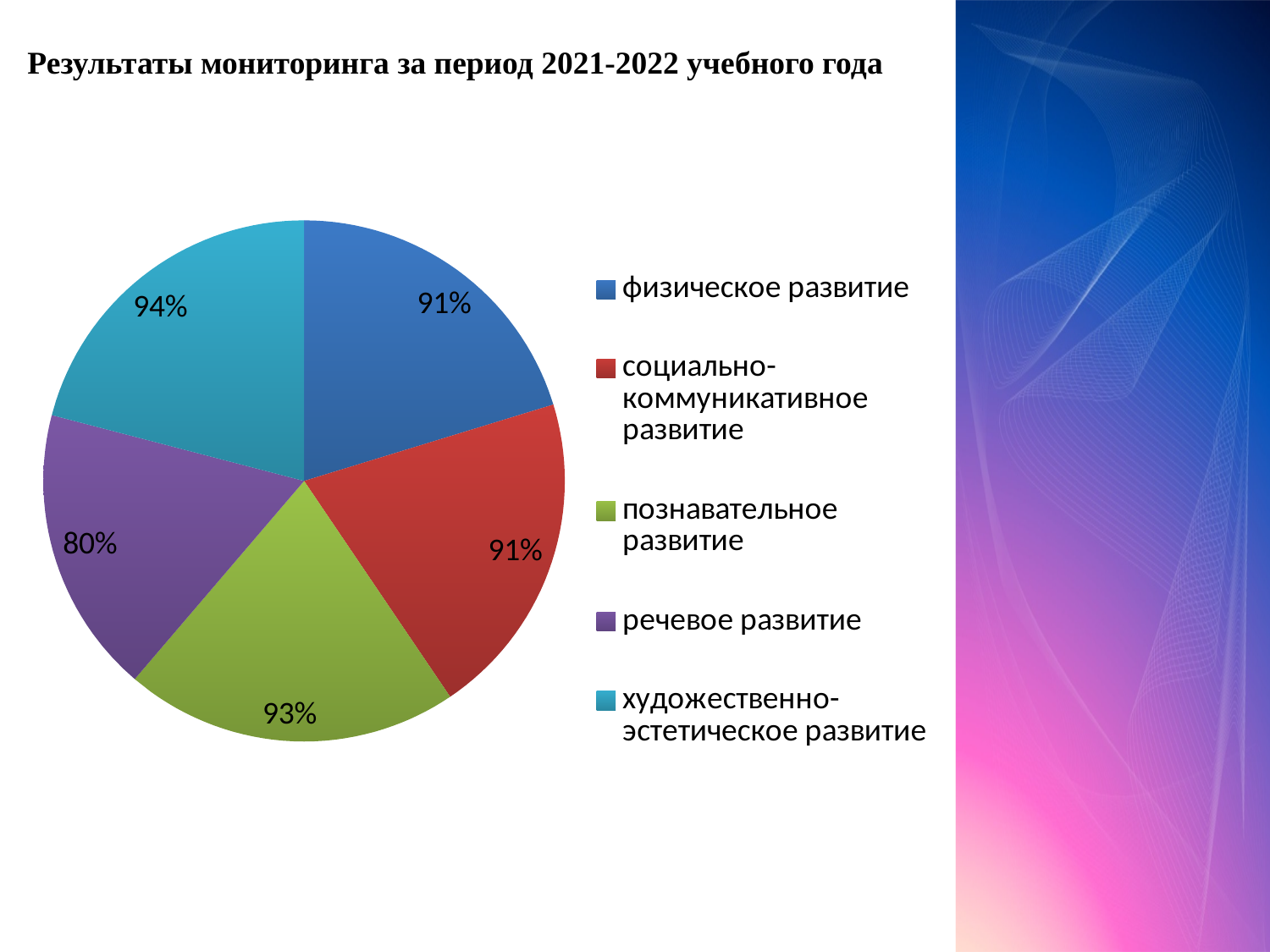
What value is shown for социально-коммуникативное развитие? 91% Which category has the highest value? художественно-эстетическое развитие What value is shown for познавательное развитие? 93% What value is shown for художественно-эстетическое развитие? 94% How many categories are shown in the chart? 5 What is the difference between the values for художественно-эстетическое развитие and речевое развитие? 14 percentage points What kind of chart is shown on the slide? pie chart What value is shown for физическое развитие? 91% What is the title of the slide? Результаты мониторинга за период 2021-2022 учебного года Which is larger, the value for познавательное развитие or for речевое развитие? познавательное развитие Which category has the lowest value? речевое развитие What value is shown for речевое развитие? 80%